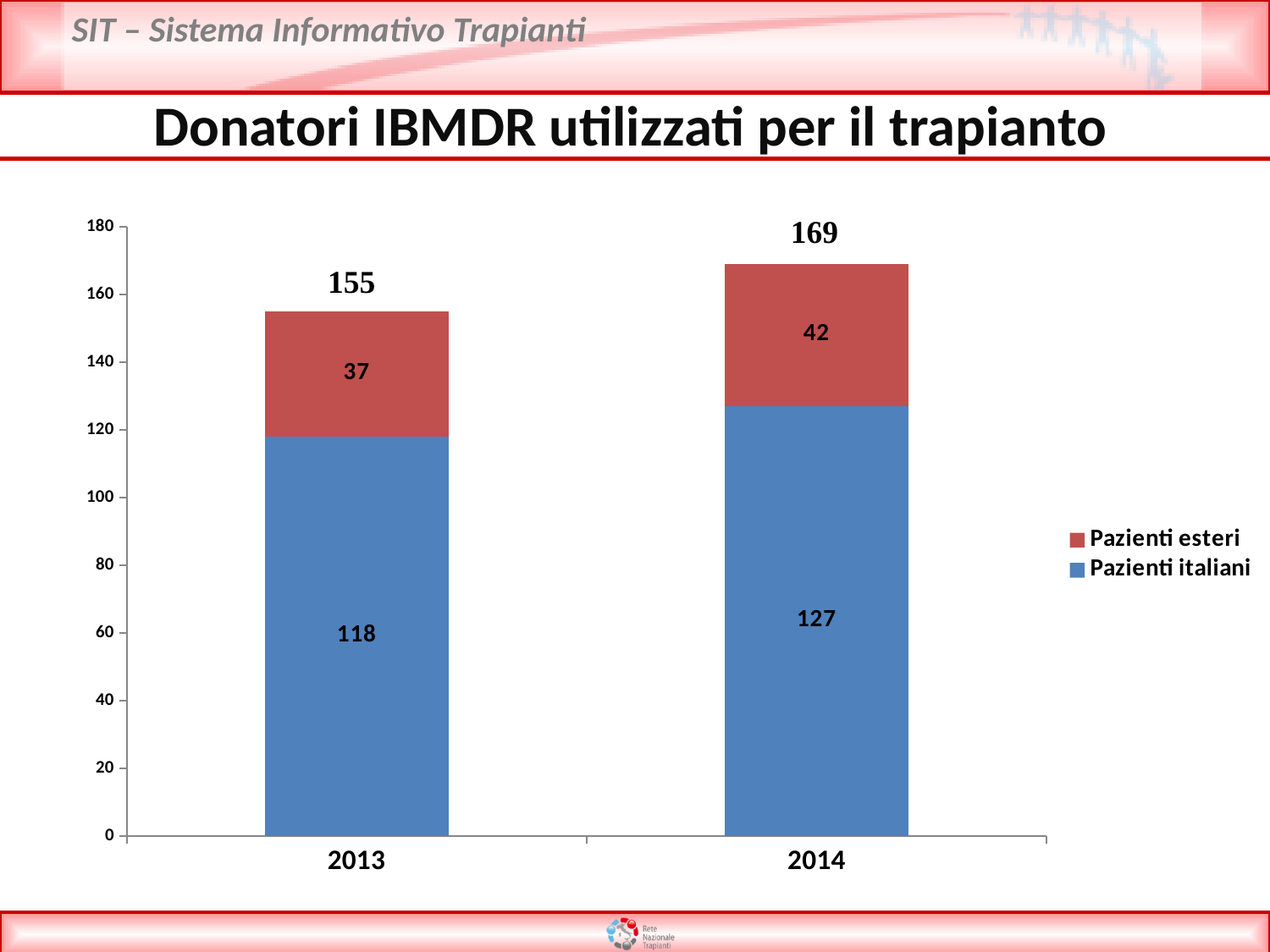
What is the total of the stacked bar for 2013? 155 How many series does the legend list? 2 Which is larger, Pazienti esteri in 2013 or Pazienti esteri in 2014? Pazienti esteri in 2014 What is the value for Pazienti esteri in 2014? 42 What is the difference between the Pazienti italiani values for 2014 and 2013? 9 What is the value for Pazienti esteri in 2013? 37 Which year has the higher total? 2014 What is the difference between the totals for 2014 and 2013? 14 How many categories are shown on the x axis? 2 What is the value for Pazienti italiani in 2013? 118 What is the total of the stacked bar for 2014? 169 What kind of chart is shown on the slide? Stacked bar chart